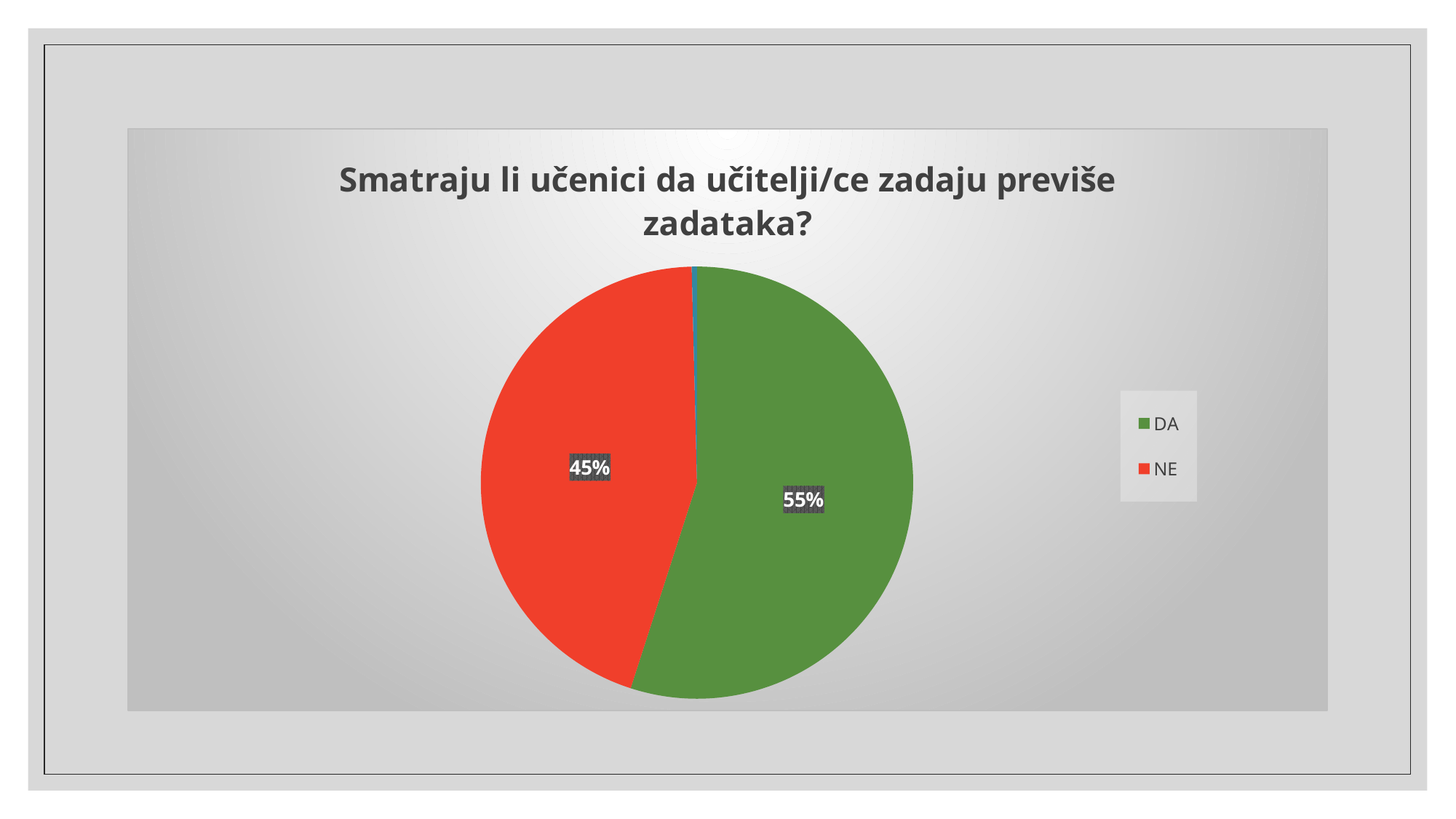
What is the title of the chart? Smatraju li učenici da učitelji/ce zadaju previše zadataka? What percentage of the pie is labelled DA? 55% What share of the pie does the NE slice take? 45% What kind of chart is shown on the slide? pie chart Which slice is the largest? DA What percentage of the pie is labelled NE? 45% What colour is the DA slice? green Which is larger, the DA slice or the NE slice? DA How many entries does the legend list? 2 What is the difference in percentage points between the DA and NE slices? 10